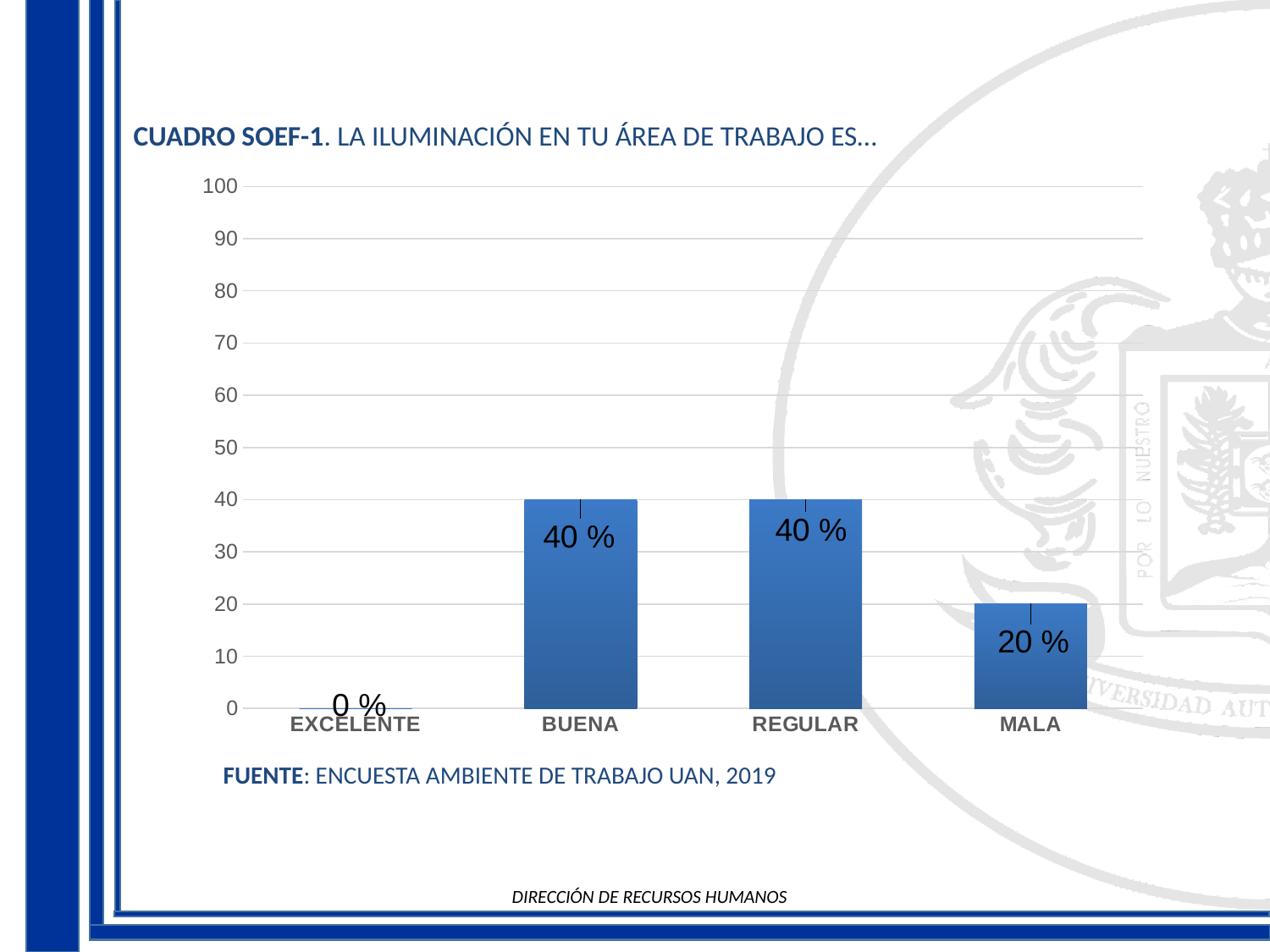
What is the value for REGULAR? 40 % What is the value for MALA? 20 % How many categories are shown on the x axis? 4 What is the maximum value shown on the y axis? 100 What is the title of the chart? CUADRO SOEF-1. LA ILUMINACIÓN EN TU ÁREA DE TRABAJO ES… Is the value for MALA greater or less than 30? less Which is larger, the value for REGULAR or the value for MALA? REGULAR What is the value for BUENA? 40 % What kind of chart is shown on the slide? bar chart What is the difference between the values for BUENA and MALA? 20 % Which category has the lowest value? EXCELENTE What is the value for EXCELENTE? 0 %